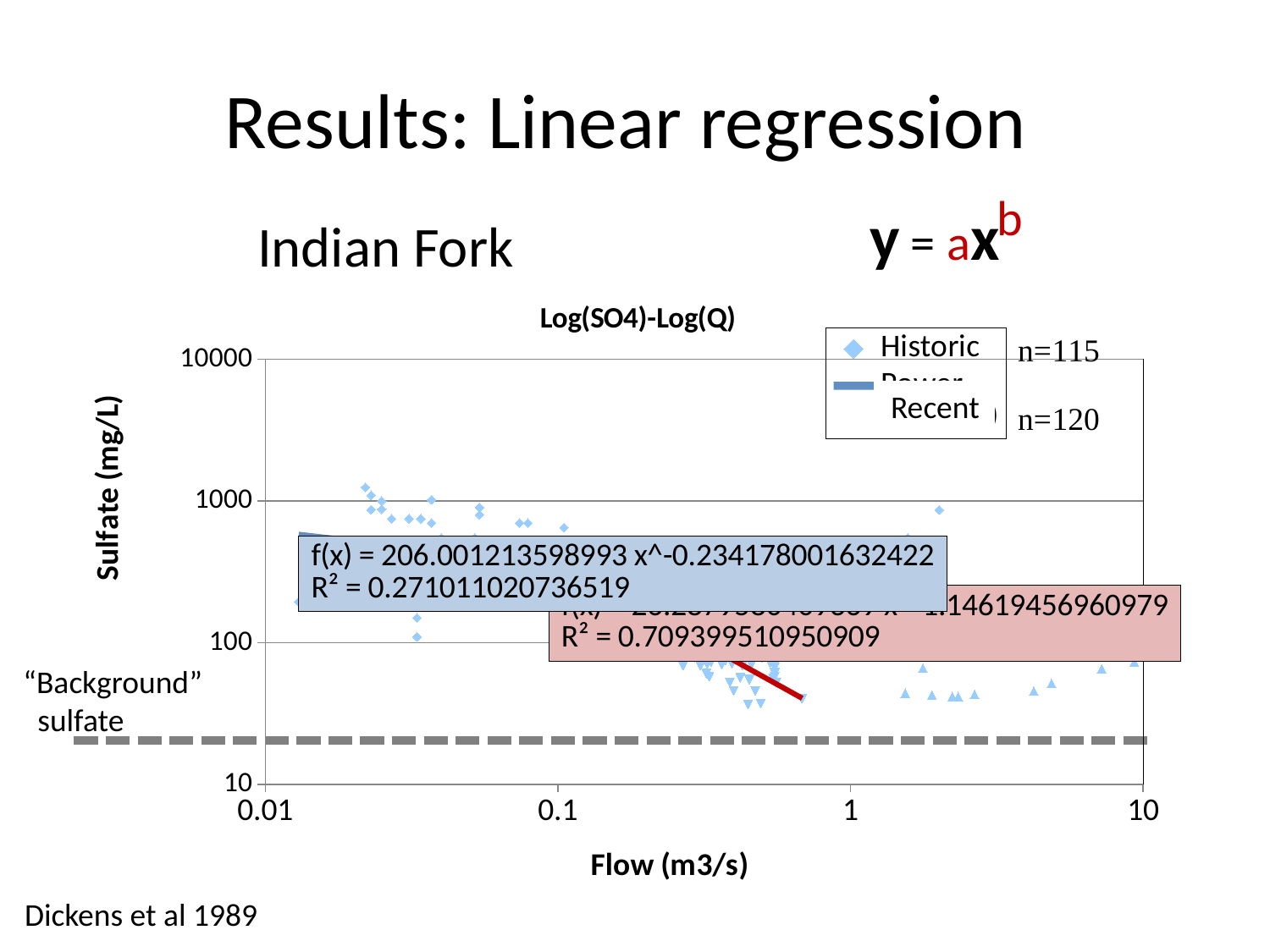
What is the lowest value shown on the horizontal axis of the chart? 0.01 How many data points (n) are noted for the Recent series? n=120 What is the R² value shown in the blue equation box on the chart? 0.271011020736519 What is the coefficient a in the fitted power equation shown in the blue box? 206.001213598993 What kind of chart is shown on the slide? Scatter chart What is the exponent in the fitted power equation shown in the blue box? -0.234178001632422 What is the highest value shown on the vertical axis of the chart? 10000 What is the label of the vertical axis of the chart? Sulfate (mg/L) What is the title of the chart? Log(SO4)-Log(Q) Do sulfate values generally rise or fall as flow increases along the x axis? Fall What is the R² value shown in the red equation box on the chart? 0.709399510950909 How many data points (n) are noted for the Historic series? n=115